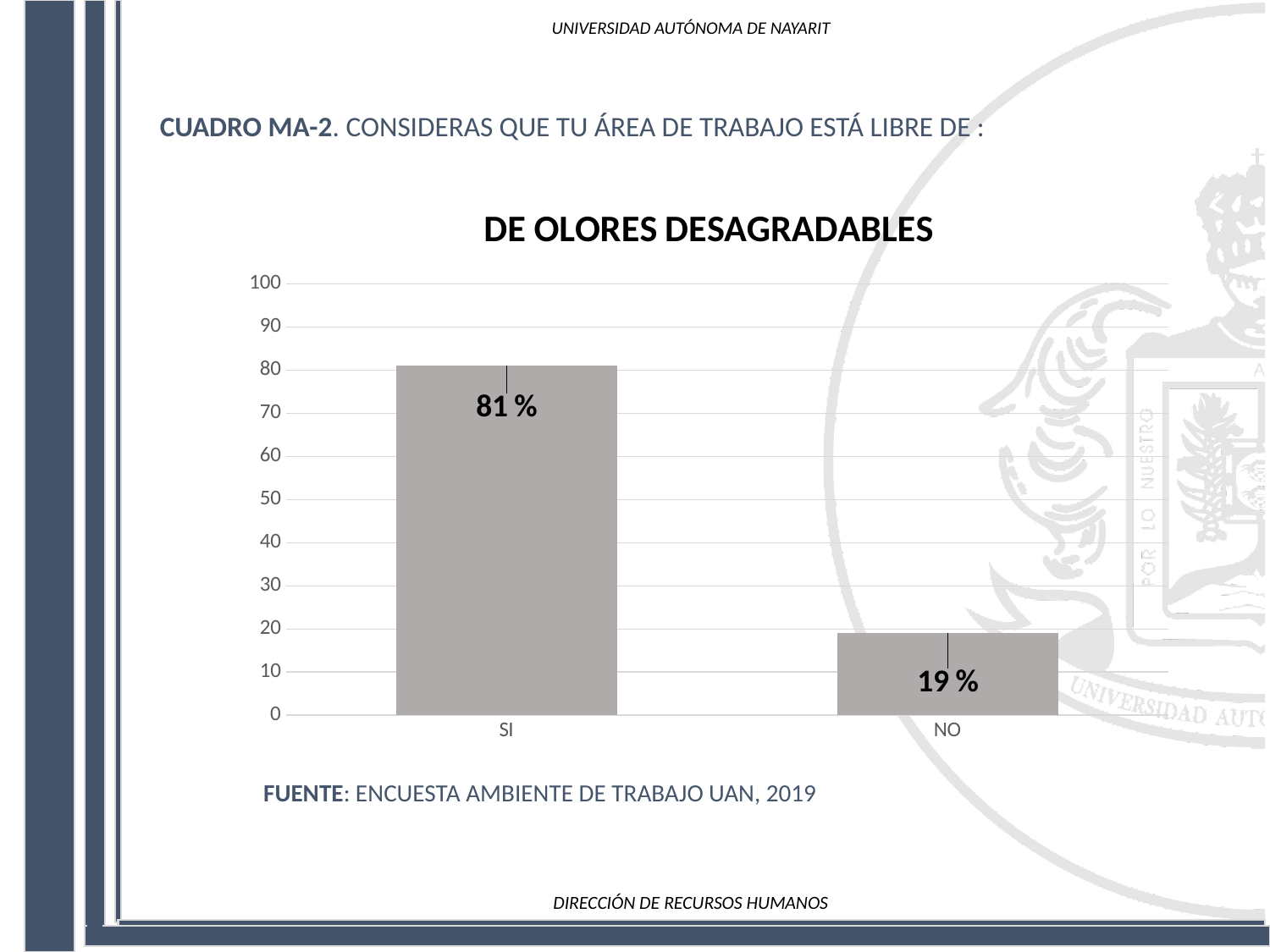
How many categories are shown on the x axis? 2 What is the value for SI? 81 % What is the difference between the values for SI and NO? 62 % What kind of chart is shown? bar chart Is the value for SI greater or less than 80? greater Which category has the lowest value? NO What is the title of the chart? DE OLORES DESAGRADABLES Which category has the highest value? SI What is the value for NO? 19 % Is the value for NO greater or less than 20? less Which is larger, the value for SI or the value for NO? SI What is the highest value shown on the y axis? 100